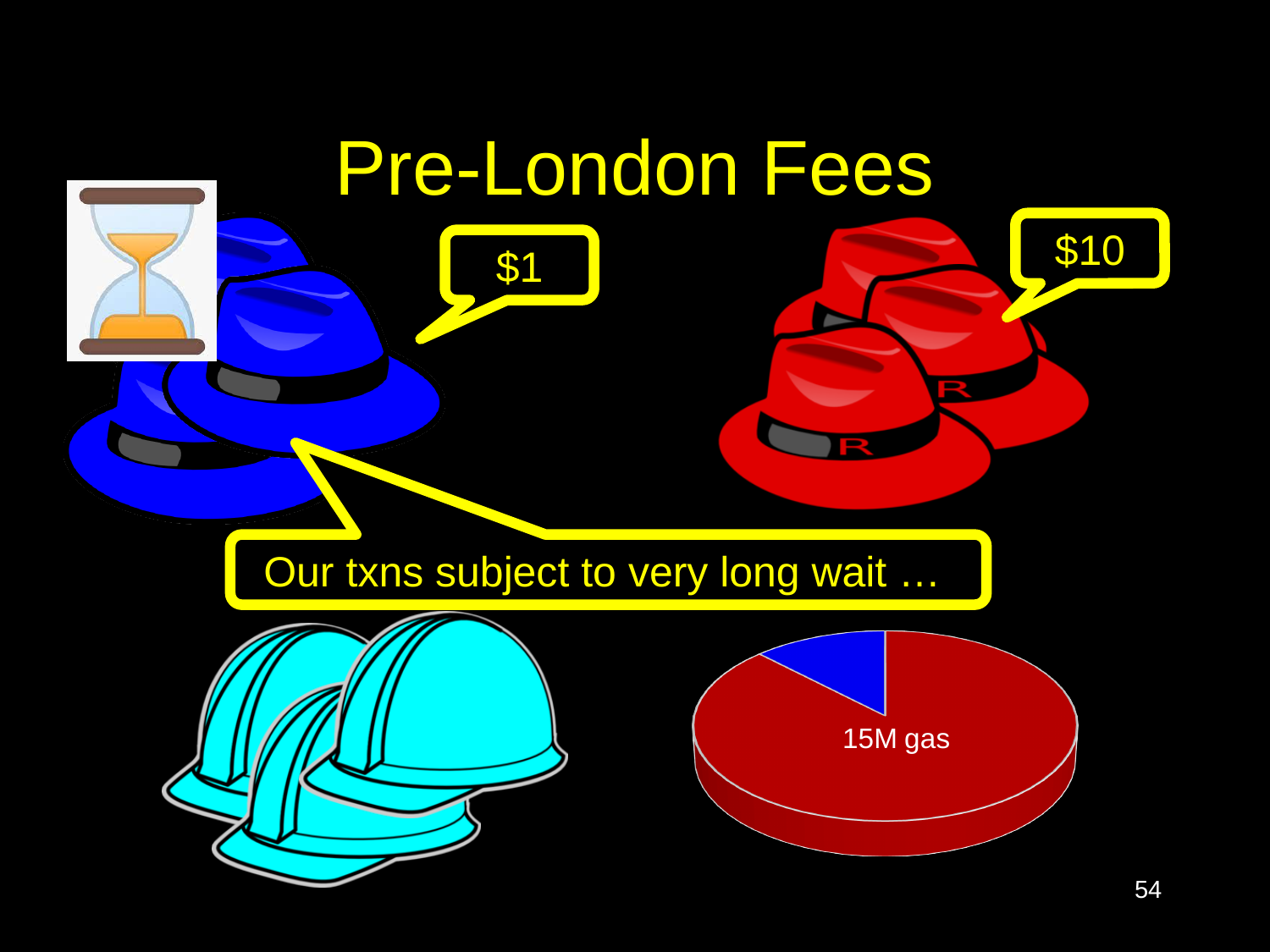
What text label is printed on the pie chart? 15M gas Which colour slice takes up the largest share of the pie chart? red What kind of chart is shown at the bottom right of the slide? pie chart What two colours are used for the slices of the pie chart? red and blue Which slice of the pie chart is larger, the red one or the blue one? red How many slices does the pie chart on the slide have? 2 Which colour slice takes up the smallest share of the pie chart? blue